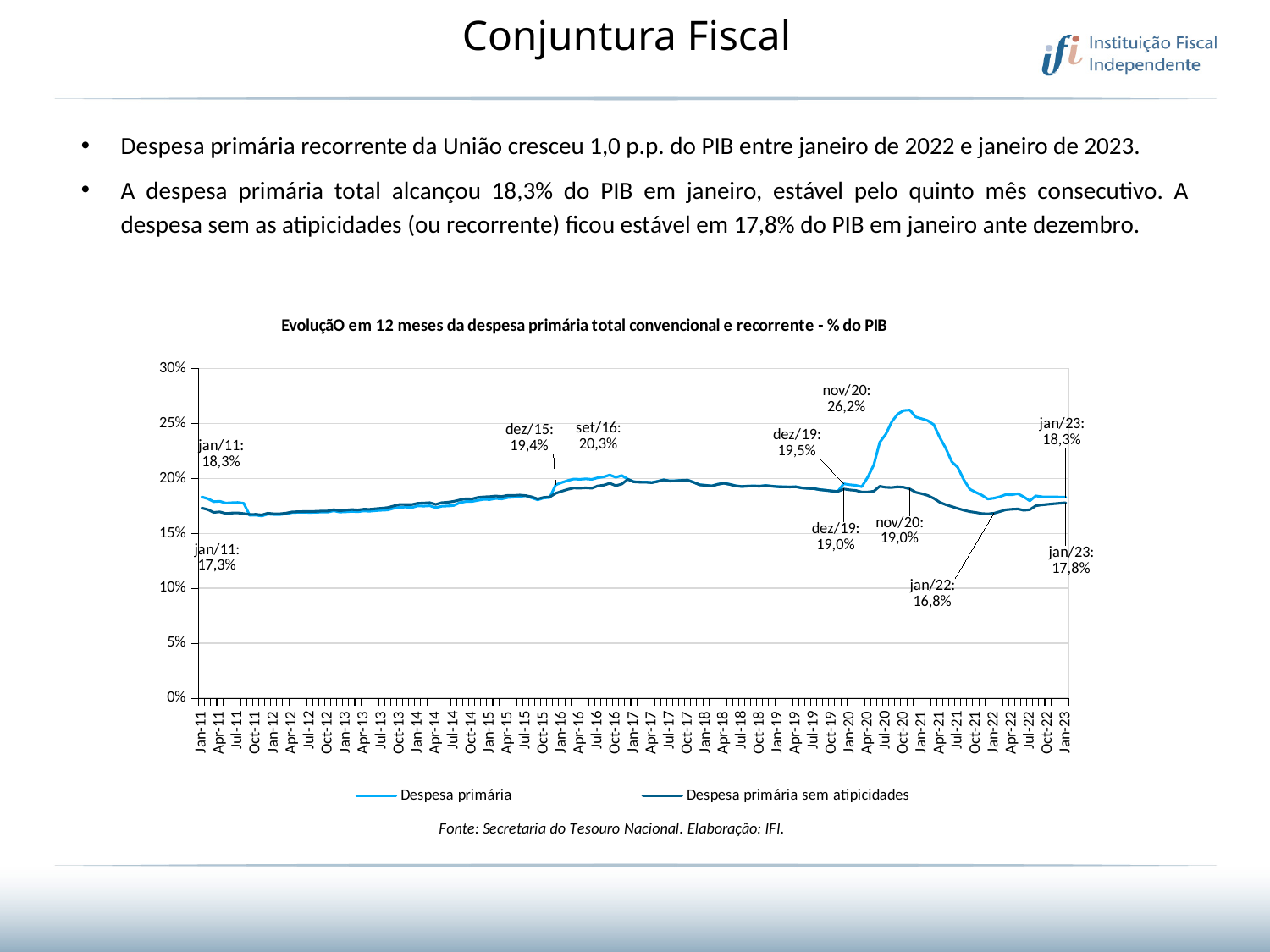
What value is labelled for Despesa primária at nov/20? 26,2% What value is labelled for Despesa primária sem atipicidades at jan/23? 17,8% How many series does the chart legend list? 2 By how much did Despesa primária sem atipicidades change between jan/22 (16,8%) and jan/23 (17,8%)? 1,0 p.p. What kind of chart is shown on the slide? line chart At which labelled date does Despesa primária reach its highest value? nov/20 What is the difference between the labelled values of the two series at jan/23 (18,3% and 17,8%)? 0,5 p.p. Is the value for Despesa primária at Jan-12 greater or less than 20%? less At jan/11, which series has the higher labelled value: Despesa primária or Despesa primária sem atipicidades? Despesa primária What is the difference between the labelled values of the two series at nov/20 (26,2% and 19,0%)? 7,2 p.p. What value is labelled for Despesa primária at set/16? 20,3% What value is labelled for Despesa primária sem atipicidades at jan/22? 16,8%